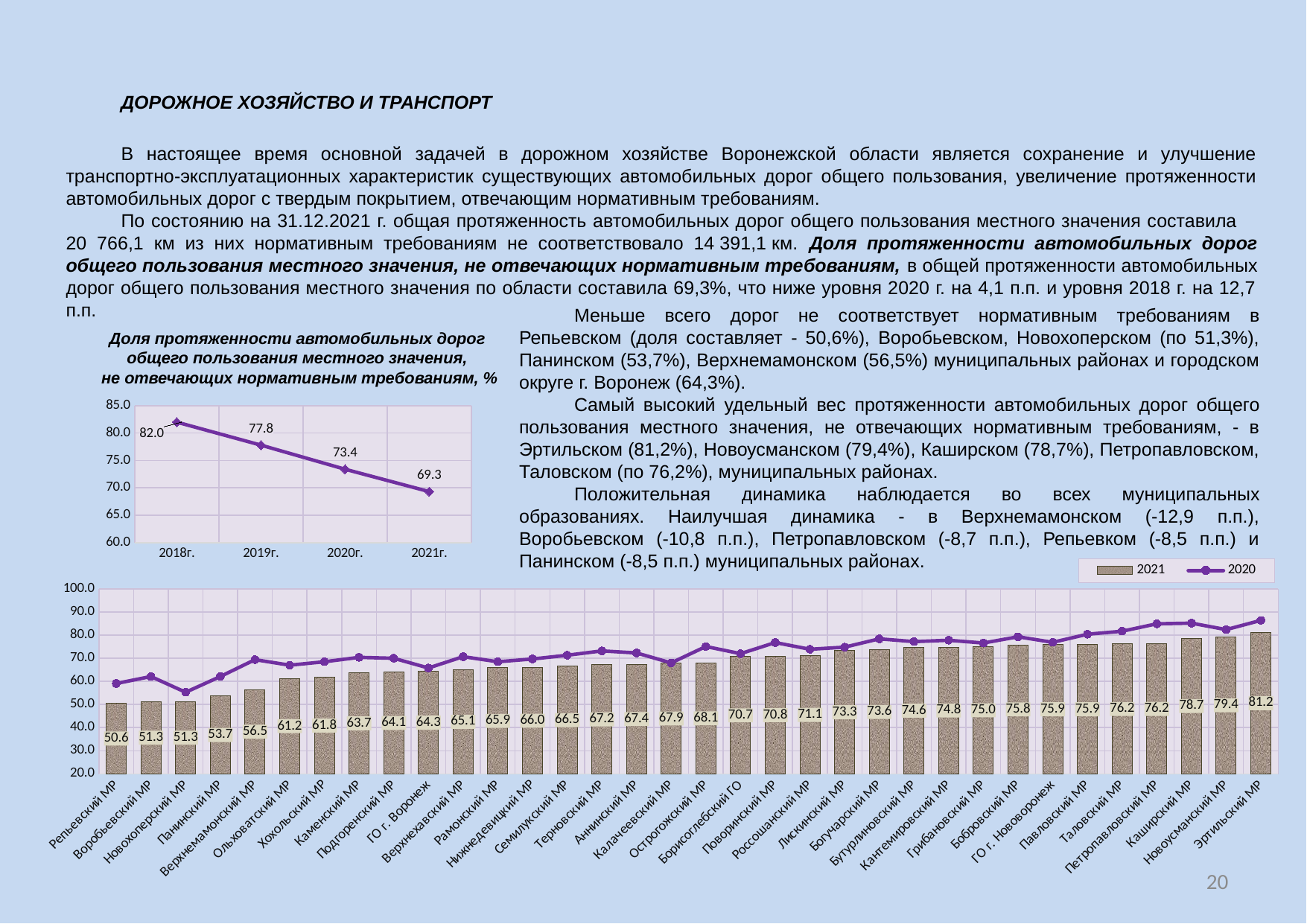
In the bottom chart, which category has the highest 2021 value? Эртильский МР In the bottom chart, which has the larger 2021 value, Каширский МР or Панинский МР? Каширский МР In the bottom chart, what is the 2021 value for ГО г. Воронеж? 64.3 In the top-left line chart, how many data points are plotted? 4 In the top-left line chart, what is the value for 2018г.? 82.0 In the bottom chart, is the 2020 value for Эртильский МР greater or less than 80.0? greater In the top-left line chart, what is the difference between the 2018г. and 2021г. values? 12.7 In the top-left line chart, do the values rise or fall from 2018г. to 2021г.? fall In the bottom chart, how many series does the legend list? 2 In the bottom chart, what is the 2021 value for Эртильский МР? 81.2 In the bottom chart, which category has the lowest 2021 value? Репьевский МР In the top-left line chart, what is the value for 2021г.? 69.3